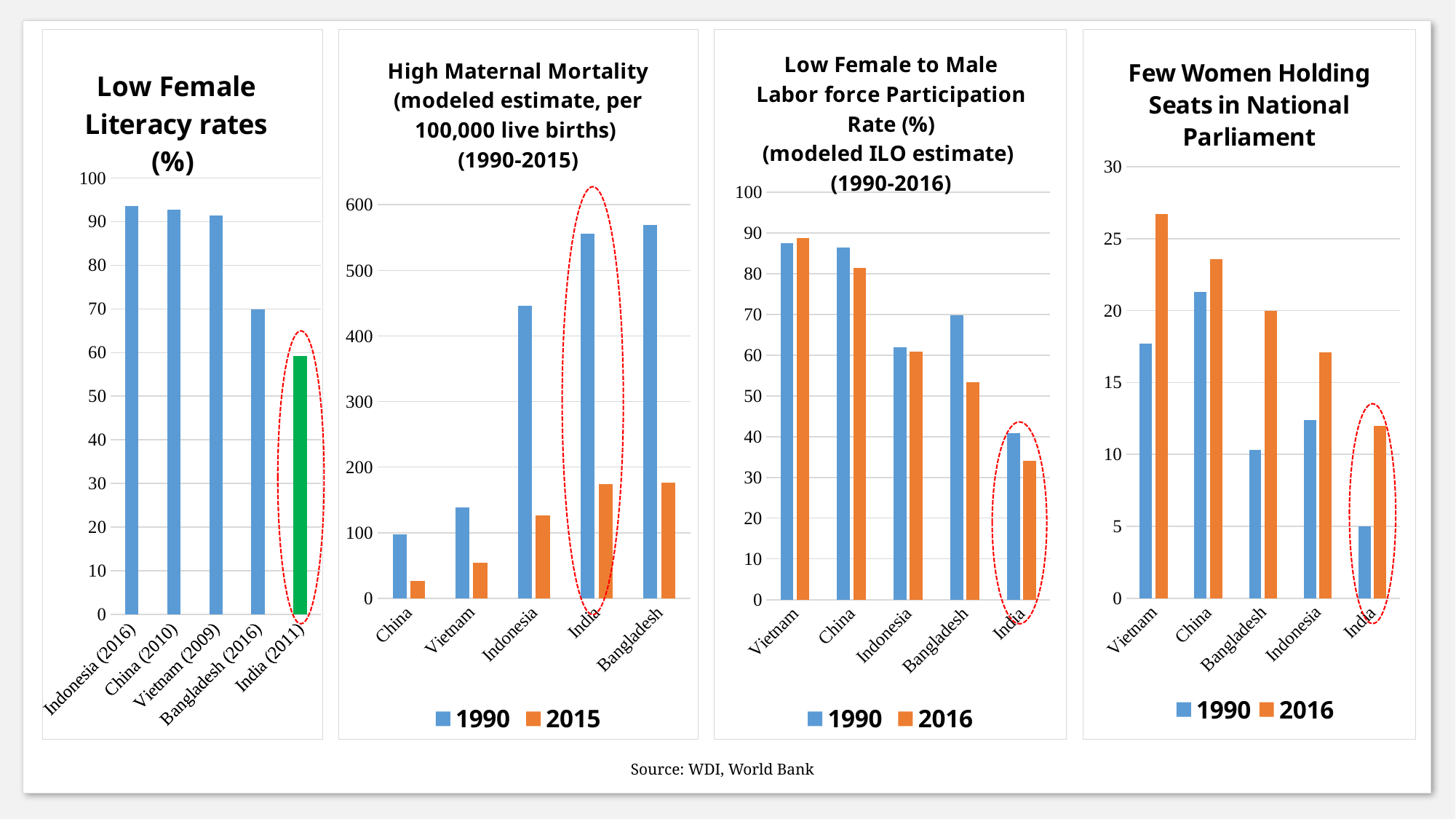
In the 'Low Female to Male Labor force Participation Rate (%)' chart, which country has the highest value for 2016? Vietnam What type of chart is the 'Few Women Holding Seats in National Parliament' chart? bar chart In the 'Low Female Literacy rates (%)' chart, how many categories are shown? 5 In the 'Low Female Literacy rates (%)' chart, which category has the lowest value? India (2011) In the 'Few Women Holding Seats in National Parliament' chart, which country has the highest value for 2016? Vietnam In the 'High Maternal Mortality' chart, is the 1990 value for India greater or less than 500? greater In the 'Low Female to Male Labor force Participation Rate (%)' chart, which is larger for Bangladesh, the 1990 value or the 2016 value? 1990 In the 'Low Female Literacy rates (%)' chart, is the value for Bangladesh (2016) greater or less than 60? greater In the 'High Maternal Mortality' chart, how many series does the legend list? 2 In the 'Low Female to Male Labor force Participation Rate (%)' chart, is the 2016 value for India greater or less than 40? less In the 'High Maternal Mortality' chart, which country has the lowest value for 1990? China